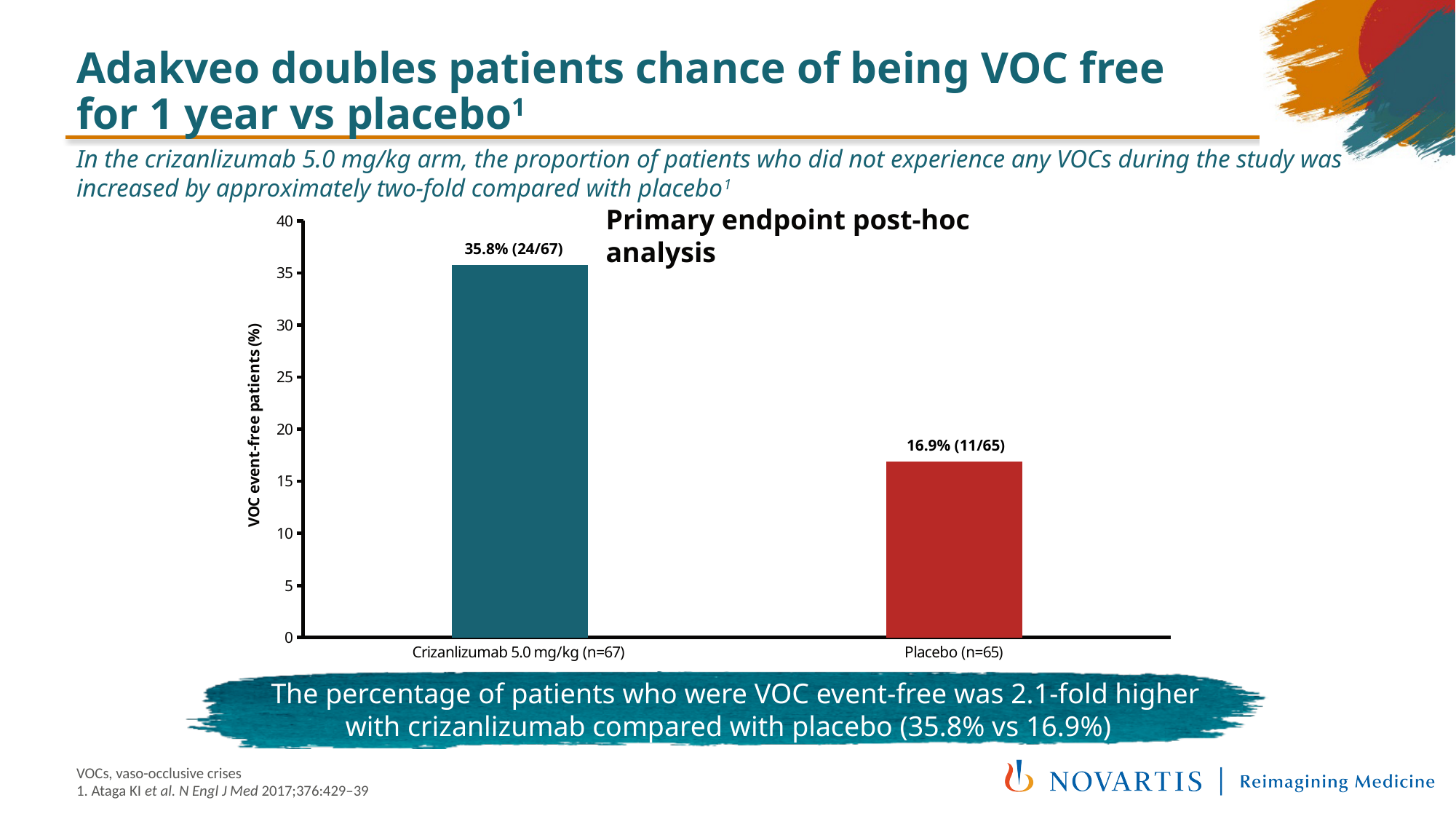
What percentage of VOC event-free patients is shown for the Crizanlizumab 5.0 mg/kg (n=67) arm? 35.8% How many patients out of the total were VOC event-free in the Placebo arm, as printed on the data label? 11/65 How many bars are plotted in the chart? 2 Is the value for the Crizanlizumab 5.0 mg/kg (n=67) arm greater or less than 30? greater What is the label of the y-axis of the chart? VOC event-free patients (%) What kind of chart is shown on the slide? Bar chart What is the difference in percentage points between the Crizanlizumab 5.0 mg/kg arm and the Placebo arm? 18.9 What percentage of VOC event-free patients is shown for the Placebo (n=65) arm? 16.9% How many patients out of the total were VOC event-free in the Crizanlizumab 5.0 mg/kg arm, as printed on the data label? 24/67 Which arm has the higher percentage of VOC event-free patients? Crizanlizumab 5.0 mg/kg (n=67) Which arm has the lower percentage of VOC event-free patients? Placebo (n=65) Is the value for the Placebo (n=65) arm greater or less than 20? less